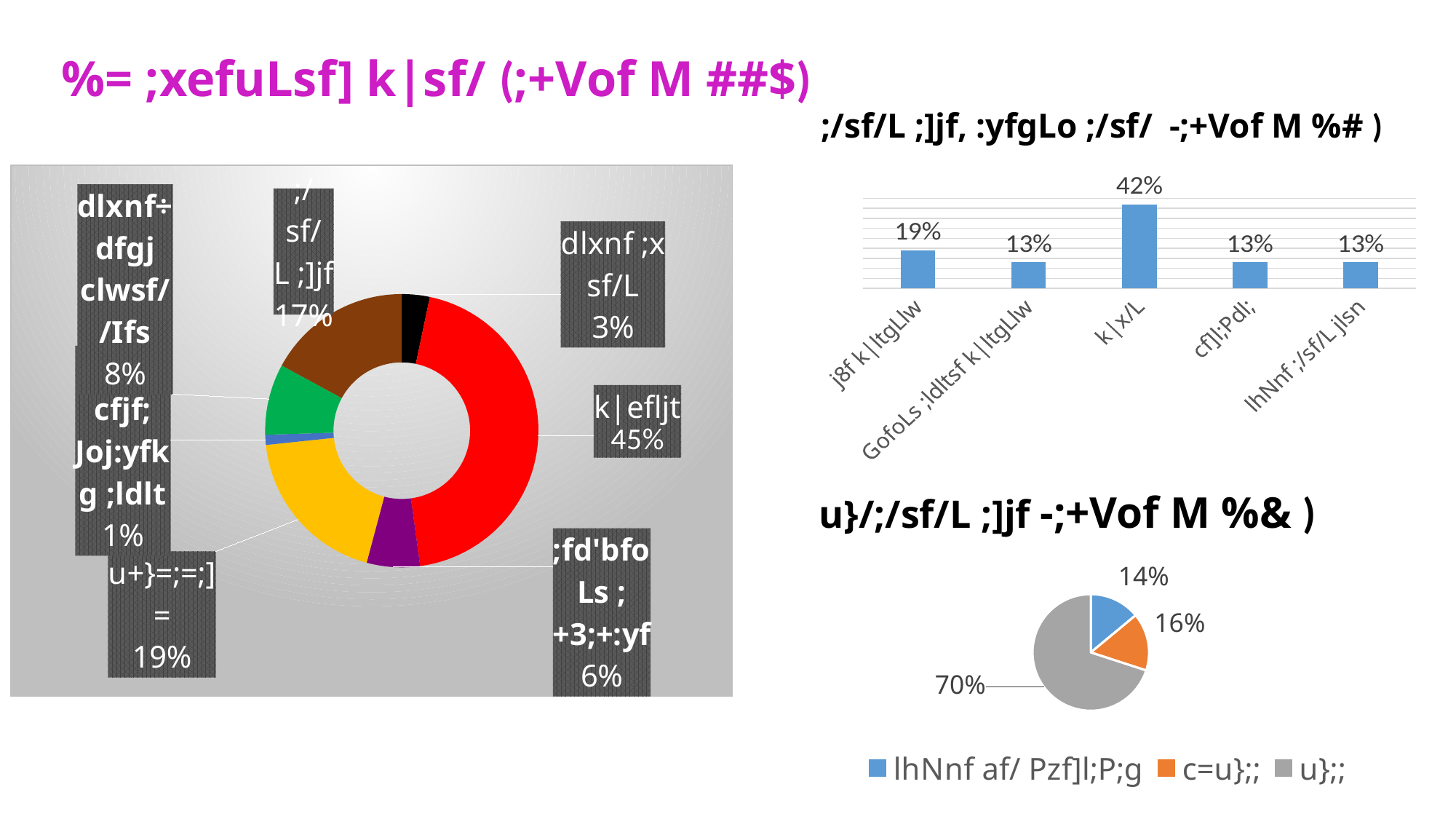
In the bar chart at the top right, what is the value of the first bar ('j8f k|ltgLlw')? 19% What kind of chart is shown at the top right of the slide? bar chart In the pie chart at the bottom right, what is the share of the largest (grey) slice? 70% In the bar chart at the top right, what is the difference between the tallest bar (42%) and the first bar (19%)? 23% In the bar chart at the top right, how many bars are plotted? 5 In the bar chart at the top right, what is the value of the tallest bar (the third category, 'k|x/L')? 42% In the pie chart at the bottom right, how many entries does the legend list? 3 In the doughnut chart on the left, which is larger: the yellow segment (19%) or the brown segment (17%)? the yellow segment (19%) In the doughnut chart on the left, what is the value of the largest (red) segment labelled 'k|efljt'? 45% In the pie chart at the bottom right, what is the share of the orange slice? 16% What kind of chart is shown at the bottom right of the slide? pie chart In the bar chart at the top right, how many bars have the value 13%? 3